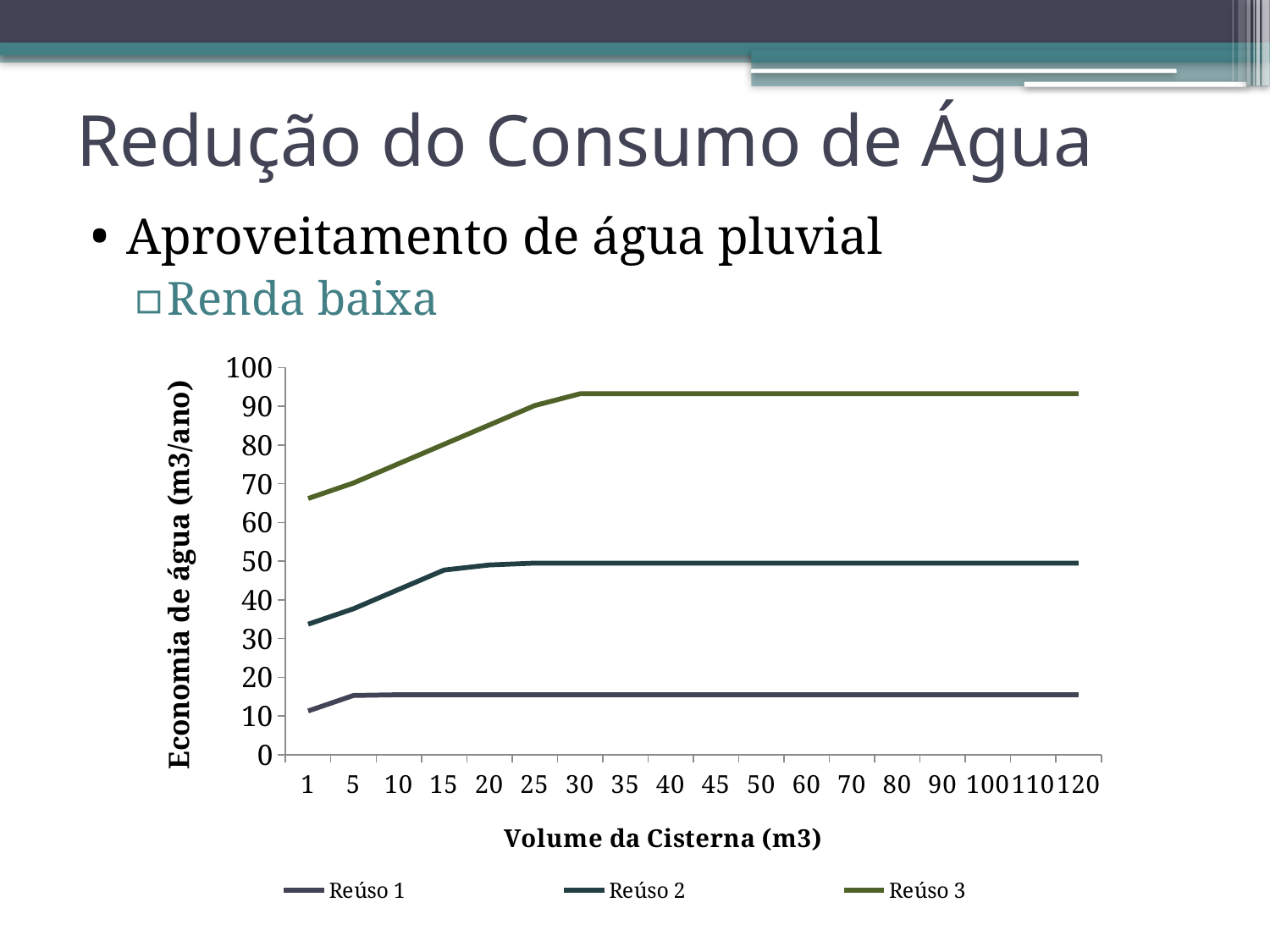
What is the title of the y axis of the chart? Economia de água (m3/ano) What kind of chart is shown on the slide? line chart Is the value for Reúso 1 at a cistern volume of 120 m3 greater or less than 20? less Is the value for Reúso 2 at a cistern volume of 1 m3 greater or less than 30? greater How many series does the legend list? 3 Do the values for Reúso 3 rise or fall as the cistern volume increases from 1 to 30 m3? rise Is the value for Reúso 3 at a cistern volume of 1 m3 greater or less than 60? greater Which series has the lowest water savings at a cistern volume of 50 m3? Reúso 1 How many cistern volume values are marked along the x axis? 18 Which series has the highest water savings at a cistern volume of 120 m3? Reúso 3 At a cistern volume of 30 m3, which is larger: the value for Reúso 2 or the value for Reúso 1? Reúso 2